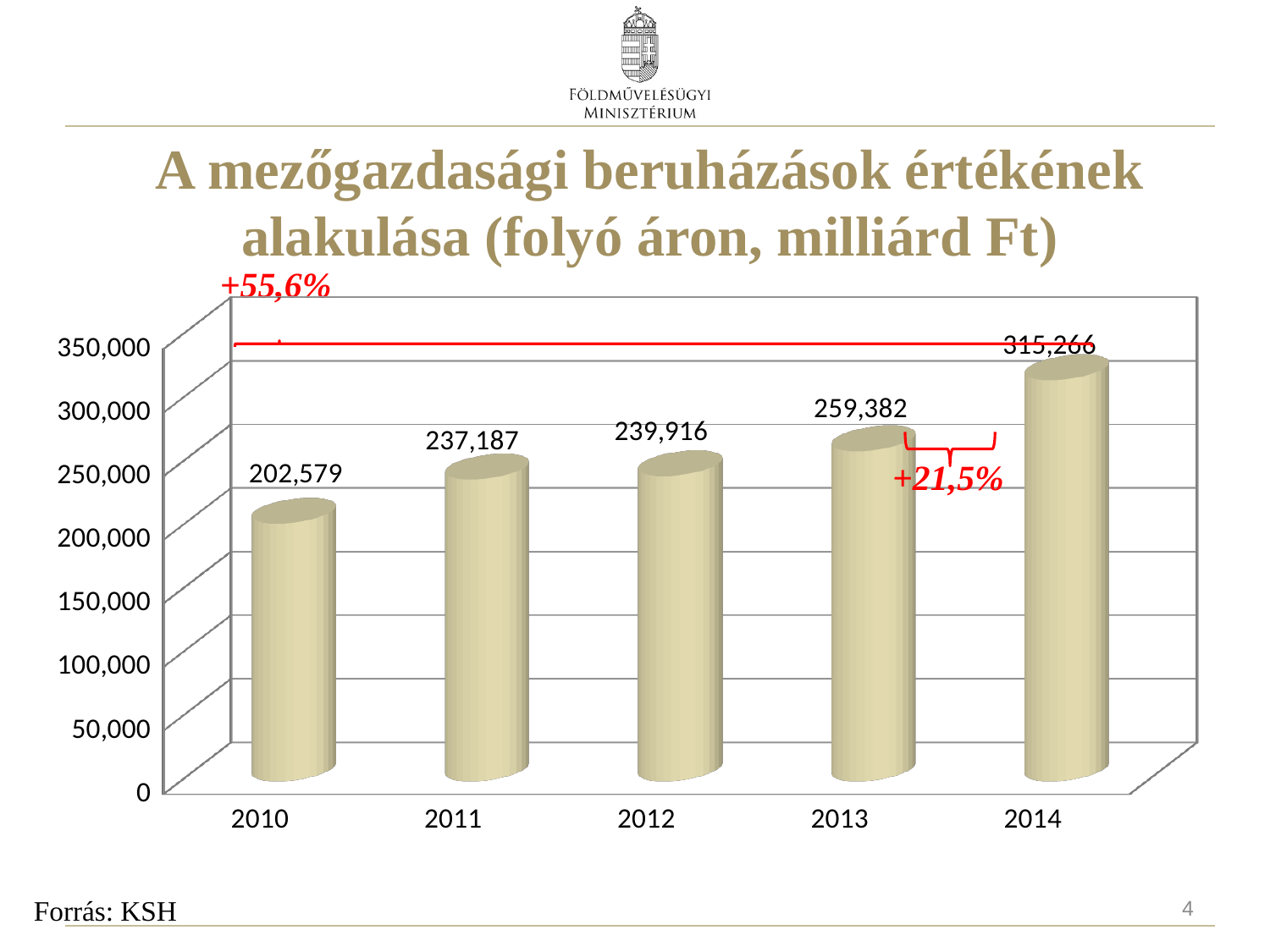
How many years are shown on the x axis? 5 Which year has the highest value? 2014 What is the value for 2014? 315,266 What is the difference between the values for 2011 and 2010? 34,608 What is the value for 2010? 202,579 What percentage change is annotated in red between 2013 and 2014? +21,5% What is the difference between the values for 2014 and 2013? 55,884 What kind of chart is shown on the slide? bar chart Is the value for 2012 greater or less than 250,000? less What is the value for 2013? 259,382 Which year has the lowest value? 2010 Which is larger, the value for 2011 or the value for 2012? 2012